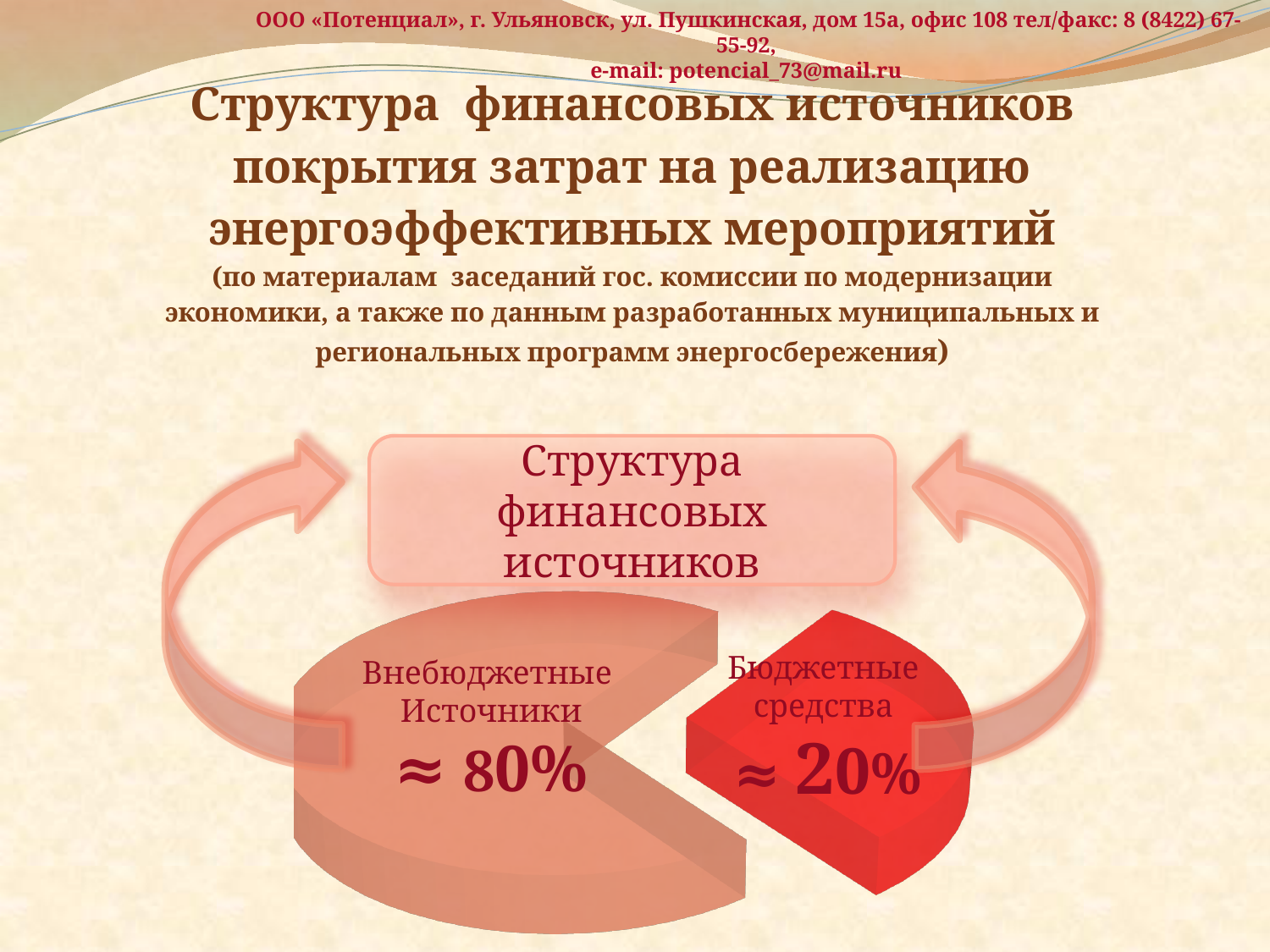
What kind of chart is shown on the slide? pie chart Which slice of the pie chart is the largest? Внебюджетные Источники What value is printed on the slice labelled Бюджетные средства? ≈ 20% What colour is the slice labelled Бюджетные средства? red How many slices does the pie chart have? 2 What share of the pie is labelled for Бюджетные средства? ≈ 20% What value is printed on the slice labelled Внебюджетные Источники? ≈ 80% Which slice of the pie chart is the smallest? Бюджетные средства Which is larger in the pie chart: Внебюджетные Источники or Бюджетные средства? Внебюджетные Источники What text is written in the box above the pie chart? Структура финансовых источников